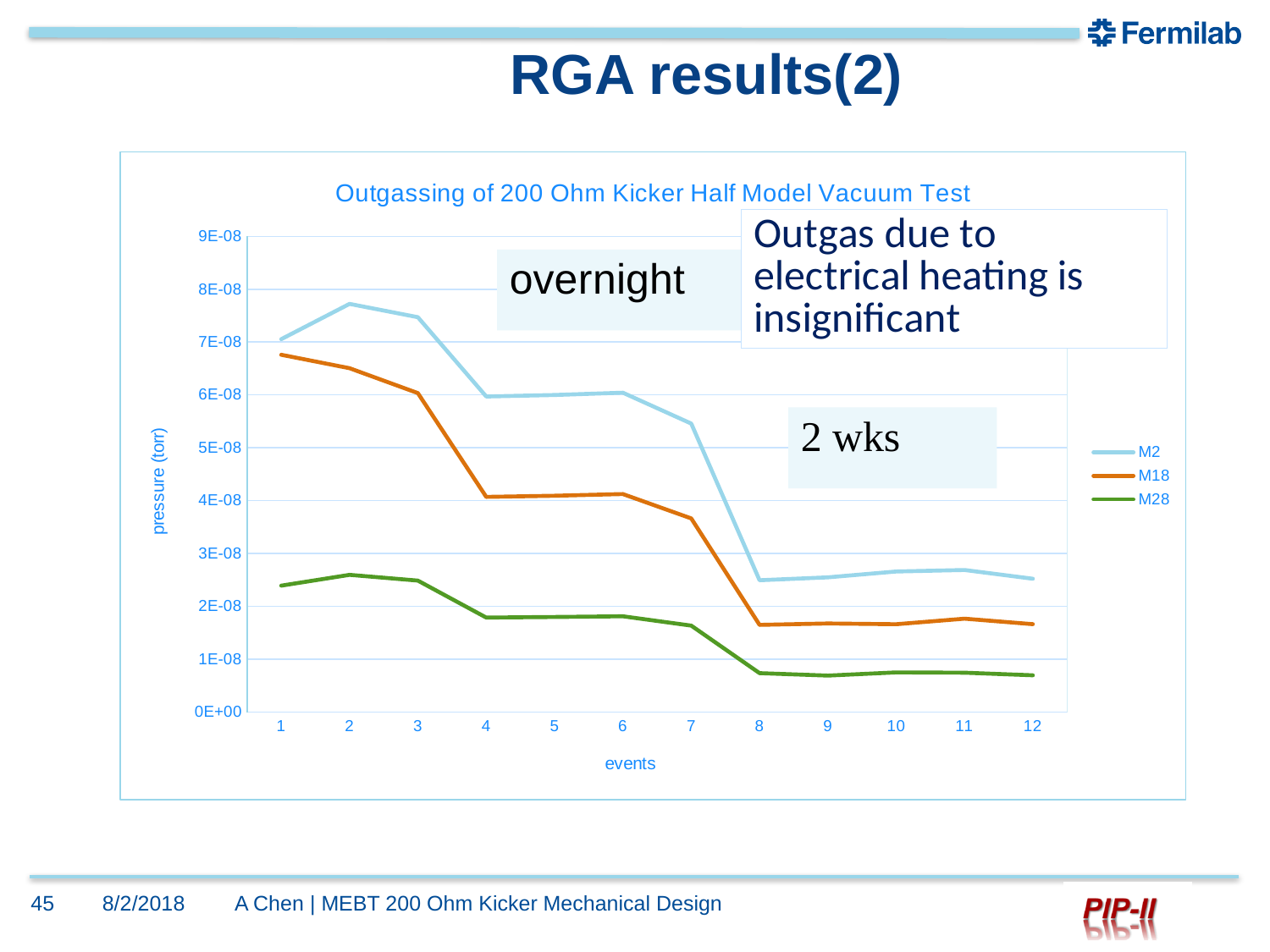
How many events are plotted along the x axis? 12 What is the title of the chart? Outgassing of 200 Ohm Kicker Half Model Vacuum Test Is the M2 value at event 1 greater or less than 6E-08? greater How many series does the legend list? 3 Which series has the lowest value at event 12? M28 At event 4, which series has the larger value, M2 or M18? M2 Do the M2 values rise or fall overall from event 1 to event 12? fall Which series has the highest value at event 1? M2 Is the M28 value at event 2 greater or less than 3E-08? less Is the M18 value at event 8 greater or less than 2E-08? less What kind of chart is shown on the slide? line chart What is the label of the y axis? pressure (torr)